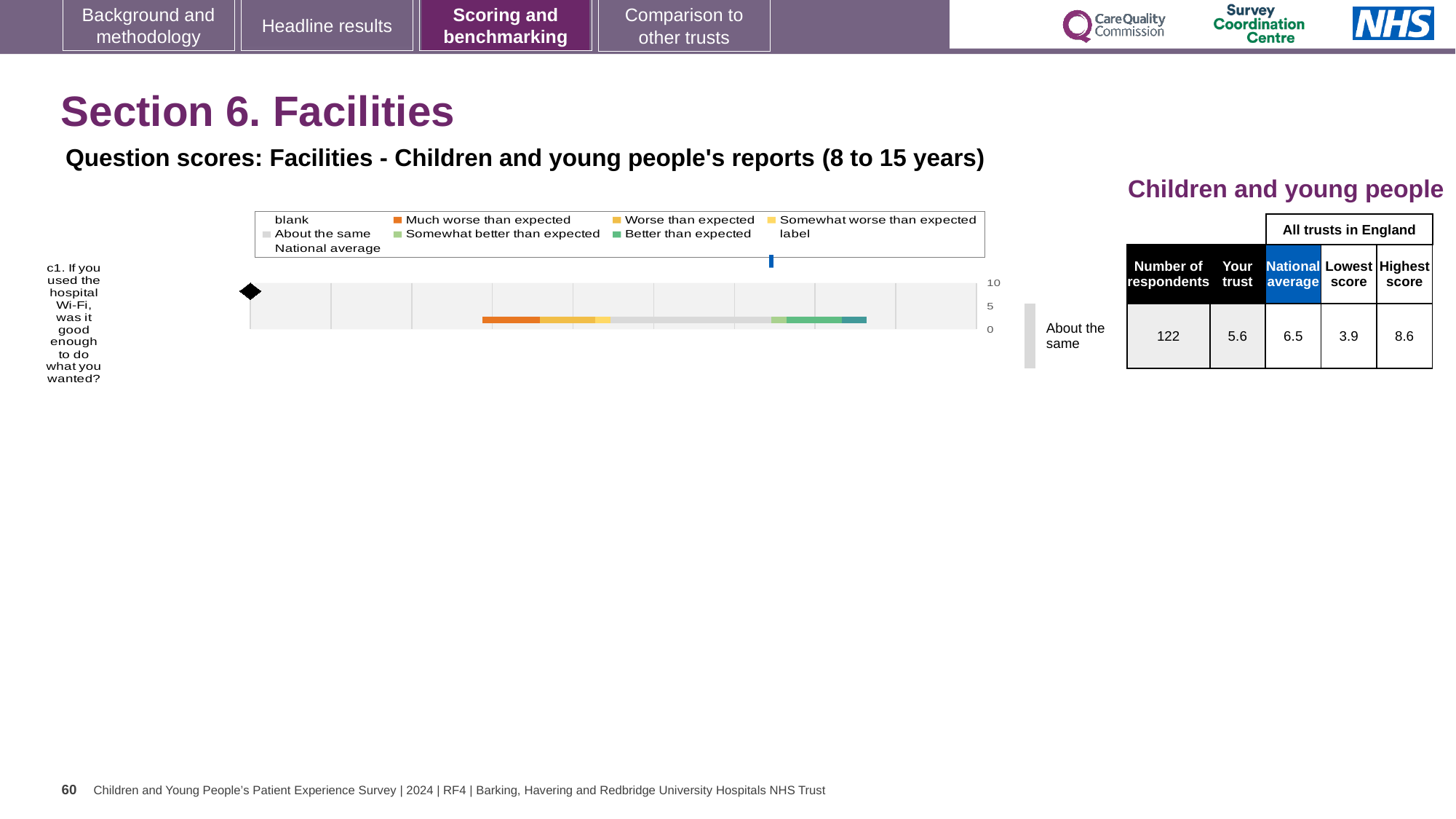
How many respondents answered question c1 for this trust? 122 What kind of chart is used to show the question score for c1 on this slide? bar chart What is the lowest score among all trusts in England for question c1? 3.9 What is the highest score among all trusts in England for question c1? 8.6 Which benchmark category is this trust's result for question c1 placed in? About the same Which is larger for question c1: the trust's score or the national average? National average How many survey questions are plotted in the chart on this slide? 1 What is the 'Your trust' score for question c1 (hospital Wi-Fi) shown on the slide? 5.6 What is the difference between the highest and lowest trust scores for question c1? 4.7 What is the national average score for question c1 shown on the slide? 6.5 What is the highest tick value shown on the score axis of the chart? 10 By how much does the national average exceed this trust's score for question c1? 0.9